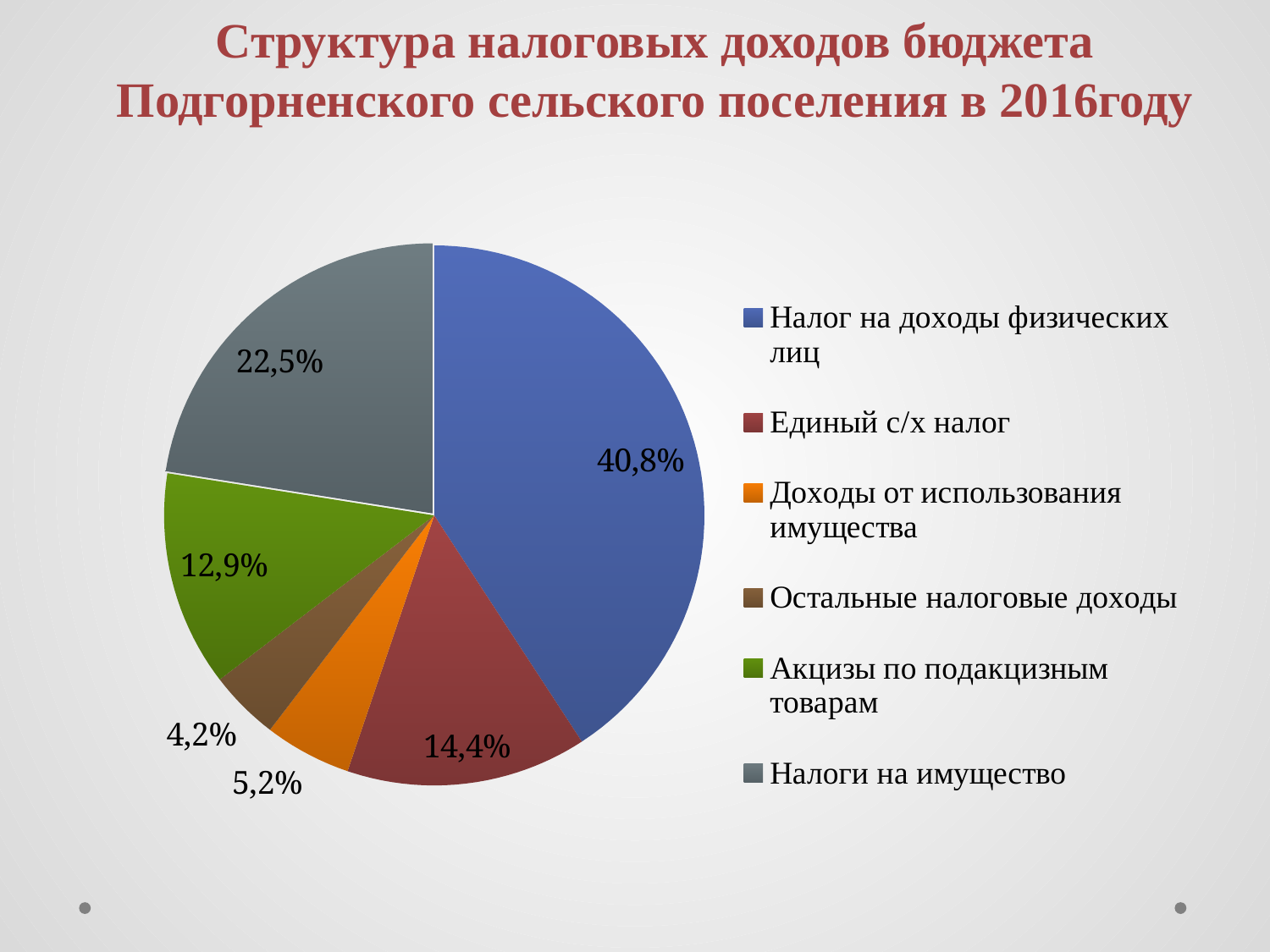
What type of chart is shown on the slide? Pie chart What share of the pie does "Налог на доходы физических лиц" represent? 40,8% What percentage is shown for "Акцизы по подакцизным товарам"? 12,9% What is the difference between the shares of "Налог на доходы физических лиц" and "Налоги на имущество"? 18,3% What colour is the slice for "Доходы от использования имущества"? Orange What is the value for "Единый с/х налог"? 14,4% Which is larger: the share of "Единый с/х налог" or the share of "Акцизы по подакцизным товарам"? Единый с/х налог Which category has the largest slice of the pie? Налог на доходы физических лиц What is the title of the chart on the slide? Структура налоговых доходов бюджета Подгорненского сельского поселения в 2016году How many slices does the pie chart have? 6 Which category has the smallest slice of the pie? Остальные налоговые доходы What is the value shown for "Налоги на имущество"? 22,5%